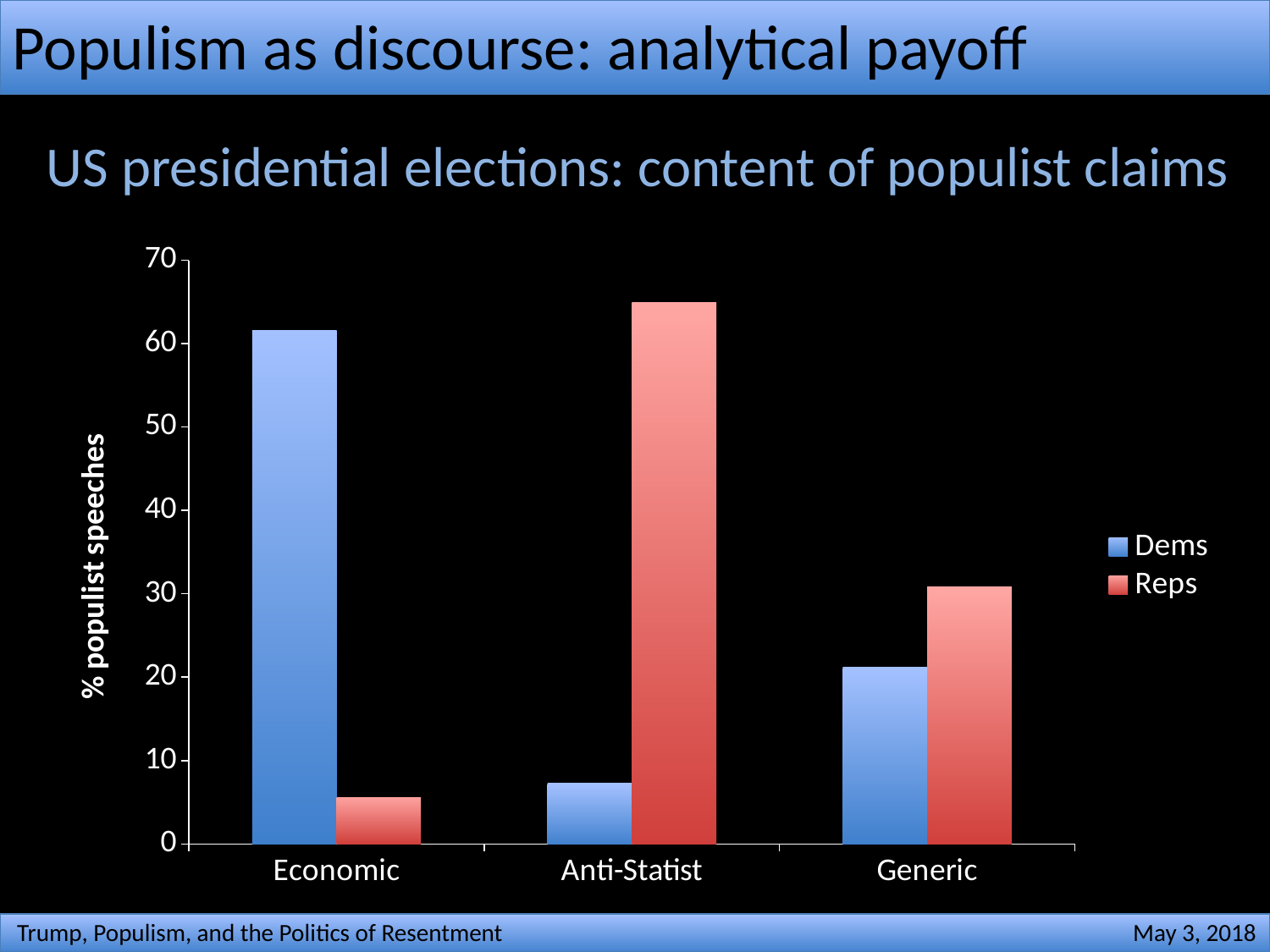
Which category has the highest Dems value? Economic Which category has the lowest Dems value? Anti-Statist What kind of chart is shown on the slide? bar chart Is the Dems value for Economic greater or less than 50? greater Is the Reps value for Economic greater or less than 10? less What is the label on the vertical axis? % populist speeches How many categories are shown on the x axis? 3 Is the Reps value for Anti-Statist greater or less than 60? greater In the Generic category, which series has the larger value, Dems or Reps? Reps Which category has the highest Reps value? Anti-Statist Which category has the lowest Reps value? Economic How many series does the legend list? 2